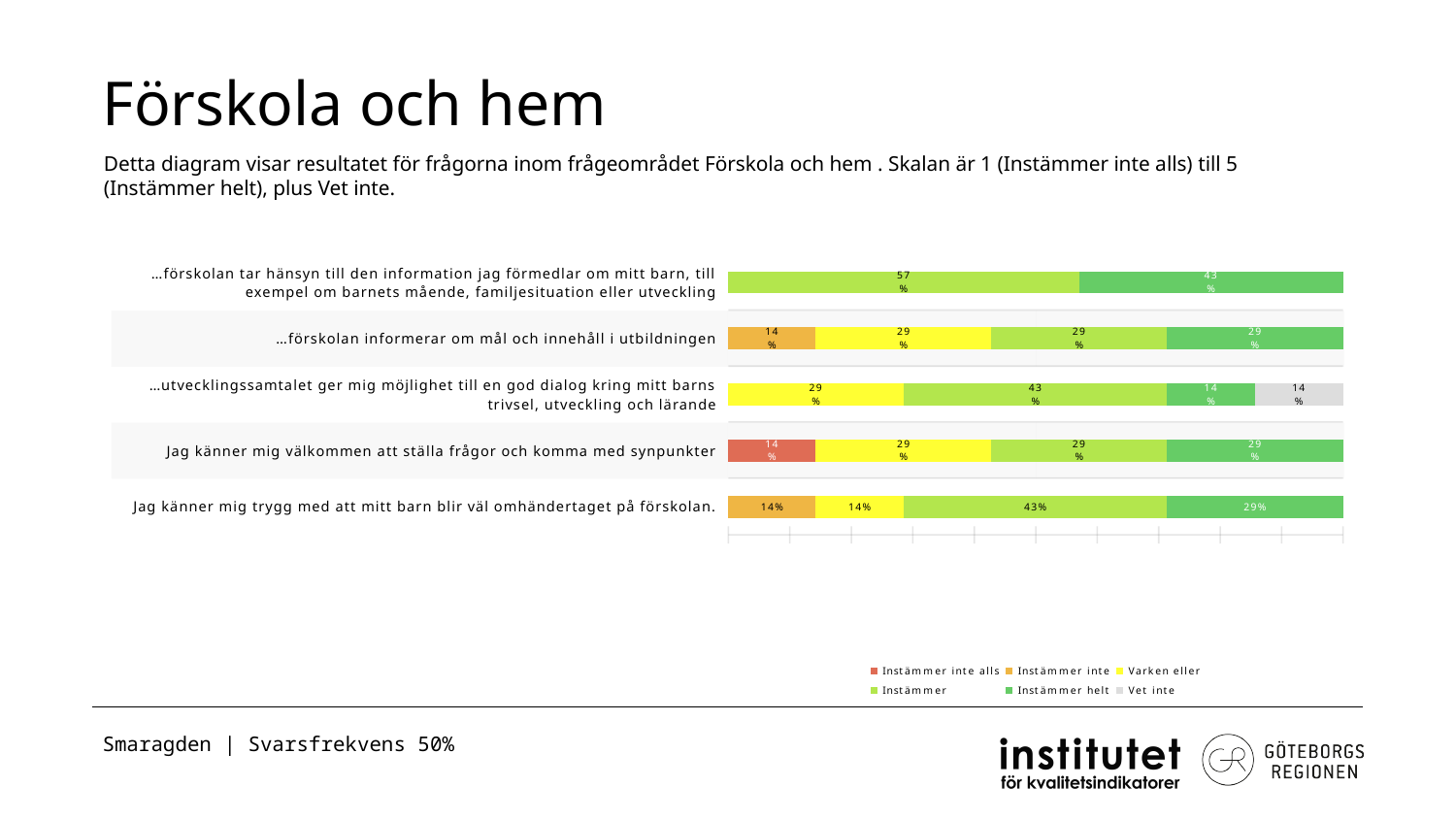
For the statement 'Jag känner mig trygg med att mitt barn blir väl omhändertaget på förskolan', which is larger: the 'Instämmer' share or the 'Instämmer helt' share? Instämmer Which legend entry is shown in grey? Vet inte What is the difference between the 'Instämmer' share and the 'Instämmer helt' share for the statement '…förskolan tar hänsyn till den information jag förmedlar om mitt barn…'? 14% What kind of chart is shown on the slide? Stacked bar chart What is the 'Instämmer inte alls' share for the statement 'Jag känner mig välkommen att ställa frågor och komma med synpunkter'? 14% What is the 'Instämmer helt' share for the statement '…förskolan tar hänsyn till den information jag förmedlar om mitt barn…'? 43% Which statement has the highest 'Instämmer helt' share? …förskolan tar hänsyn till den information jag förmedlar om mitt barn, till exempel om barnets mående, familjesituation eller utveckling What is the 'Instämmer' share for the statement 'Jag känner mig trygg med att mitt barn blir väl omhändertaget på förskolan'? 43% What is the 'Vet inte' share for the statement '…utvecklingssamtalet ger mig möjlighet till en god dialog kring mitt barns trivsel, utveckling och lärande'? 14% How many statements (categories) are plotted in the chart? 5 How many series does the legend list? 6 What is the 'Instämmer' share for the statement '…förskolan tar hänsyn till den information jag förmedlar om mitt barn…'? 57%